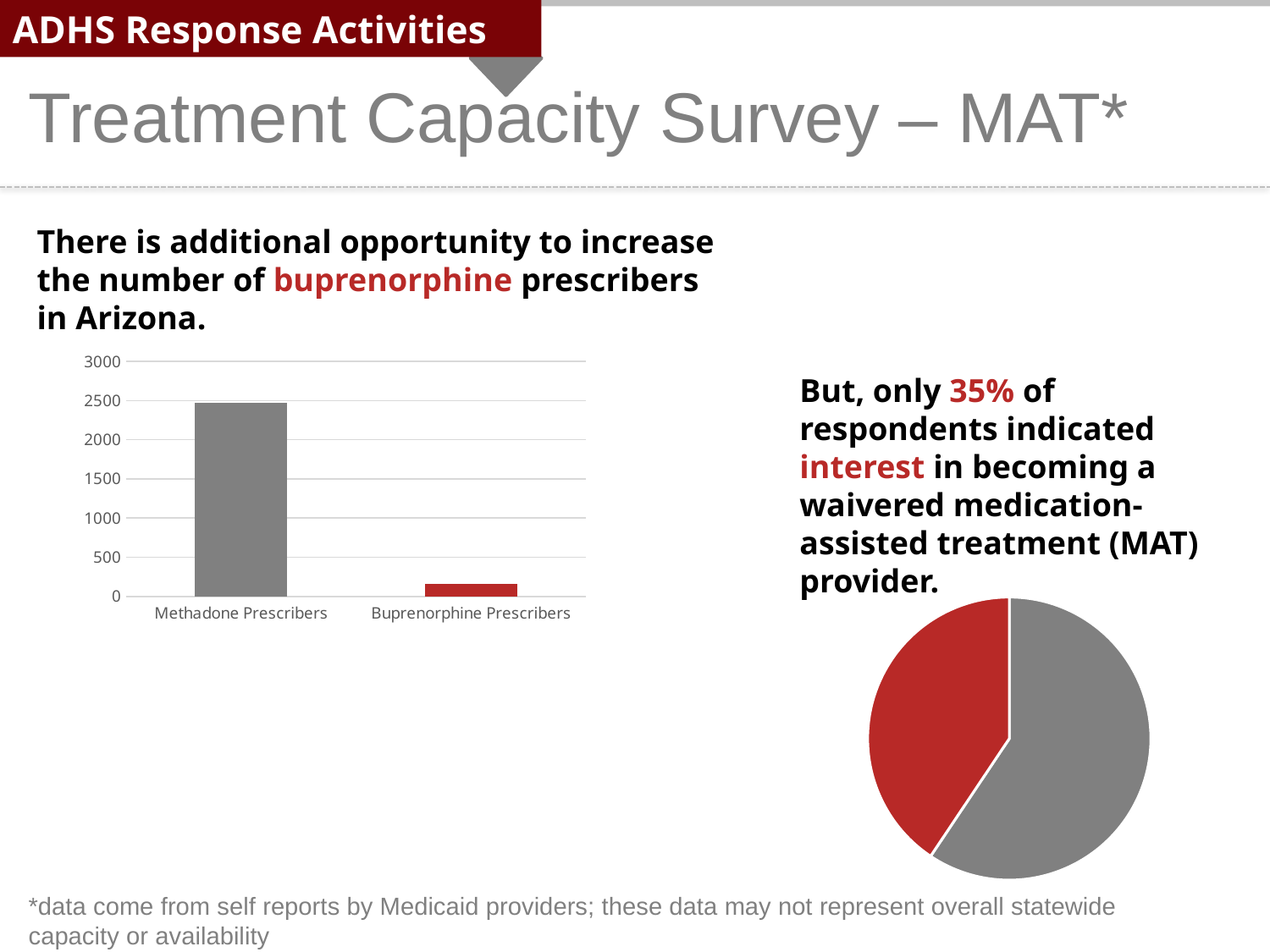
What kind of chart is shown on the right of the slide? pie chart In the bar chart, which category has the lowest value? Buprenorphine Prescribers In the bar chart, which category has the highest value? Methadone Prescribers In the pie chart, which slice is larger, the grey one or the red one? the grey one In the bar chart, which is larger: Methadone Prescribers or Buprenorphine Prescribers? Methadone Prescribers In the bar chart, is the value for Buprenorphine Prescribers greater or less than 500? less In the bar chart, is the value for Methadone Prescribers greater or less than 3000? less How many categories are shown in the bar chart? 2 How many slices does the pie chart have? 2 In the bar chart, what colour is the bar for Buprenorphine Prescribers? red What kind of chart is shown on the left of the slide? bar chart In the bar chart, is the value for Methadone Prescribers greater or less than 2000? greater